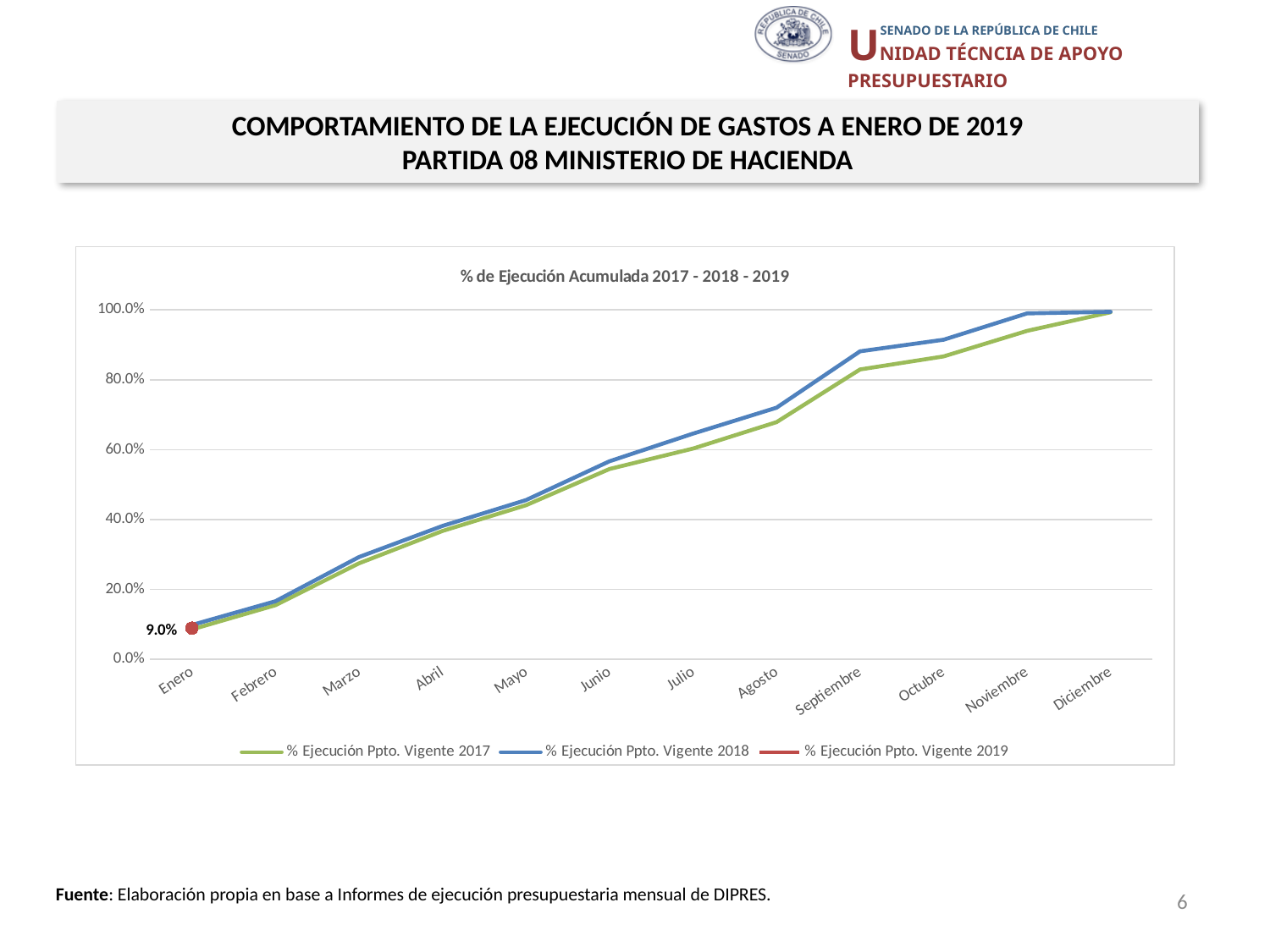
What kind of chart is shown on the slide? Line chart In Octubre, which series has the larger value: % Ejecución Ppto. Vigente 2017 or % Ejecución Ppto. Vigente 2018? % Ejecución Ppto. Vigente 2018 What colour is the line for % Ejecución Ppto. Vigente 2017? Green Is the value for % Ejecución Ppto. Vigente 2017 in Agosto greater or less than 60.0%? greater What is the value for % Ejecución Ppto. Vigente 2019 in Enero? 9.0% How many series does the chart legend list? 3 Is the value for % Ejecución Ppto. Vigente 2018 in Septiembre greater or less than 80.0%? greater In which month does % Ejecución Ppto. Vigente 2018 reach its highest value? Diciembre How many months are shown on the x axis of the chart? 12 Do the values for % Ejecución Ppto. Vigente 2018 rise or fall from Enero to Diciembre? Rise Is the value for % Ejecución Ppto. Vigente 2017 in Marzo greater or less than 20.0%? greater What is the title of the chart? % de Ejecución Acumulada 2017 - 2018 - 2019